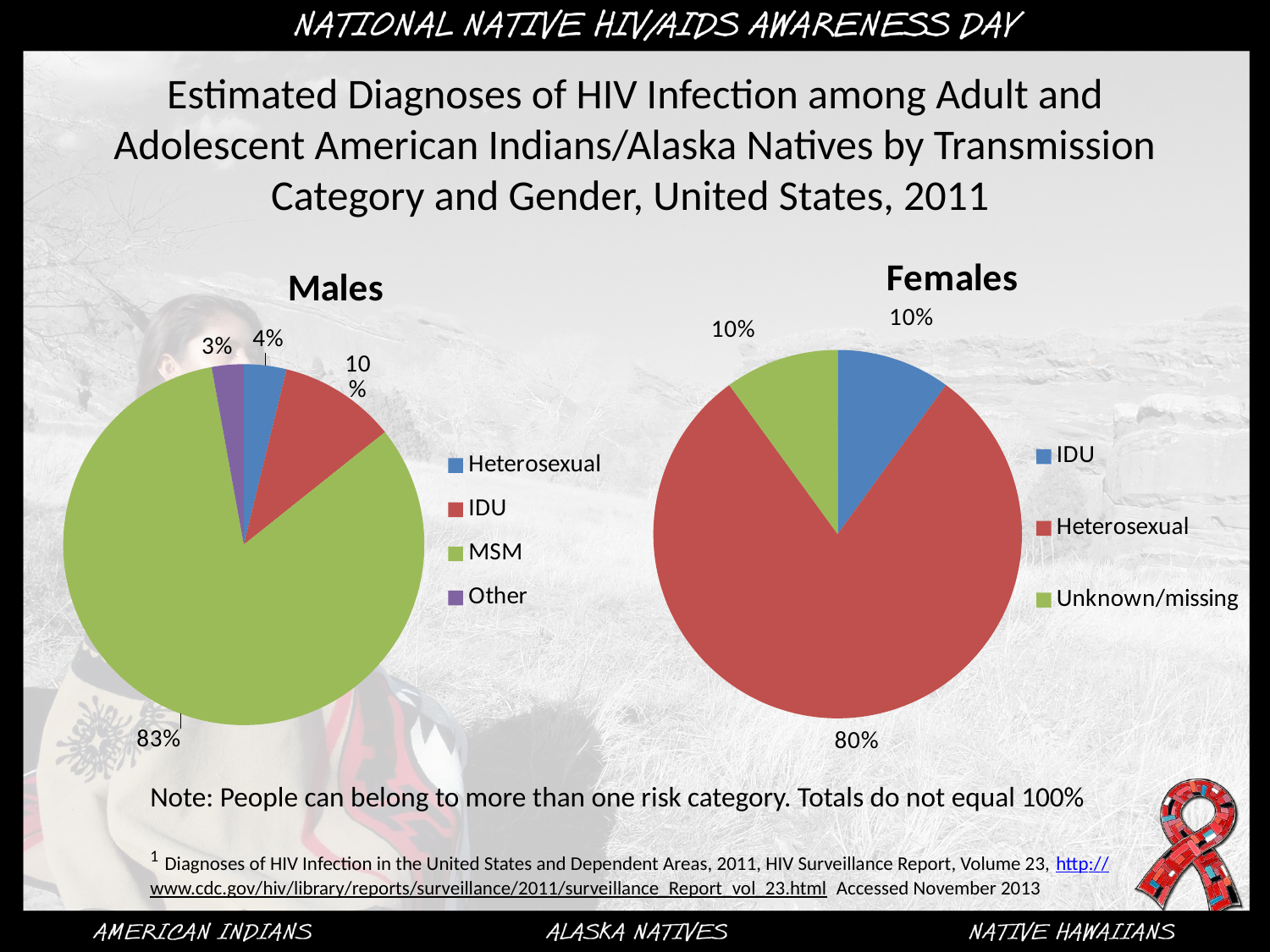
In the Males pie chart, which transmission category has the largest share? MSM In the Females pie chart, what percentage is shown for Heterosexual? 80% What type of chart is used for the Males data? Pie chart In the Females pie chart, what percentage is shown for Unknown/missing? 10% In the Males pie chart, what percentage is shown for MSM? 83% In the Males pie chart, what percentage is shown for IDU? 10% In the Males pie chart, which transmission category has the smallest share? Other How many categories does the legend of the Females pie chart list? 3 Which is larger: the Heterosexual share in the Males chart or the Heterosexual share in the Females chart? Females In the Males pie chart, what is the difference between the IDU and Heterosexual percentages? 6% In the Females pie chart, which transmission category has the largest share? Heterosexual In the Males pie chart, what percentage is shown for Other? 3%